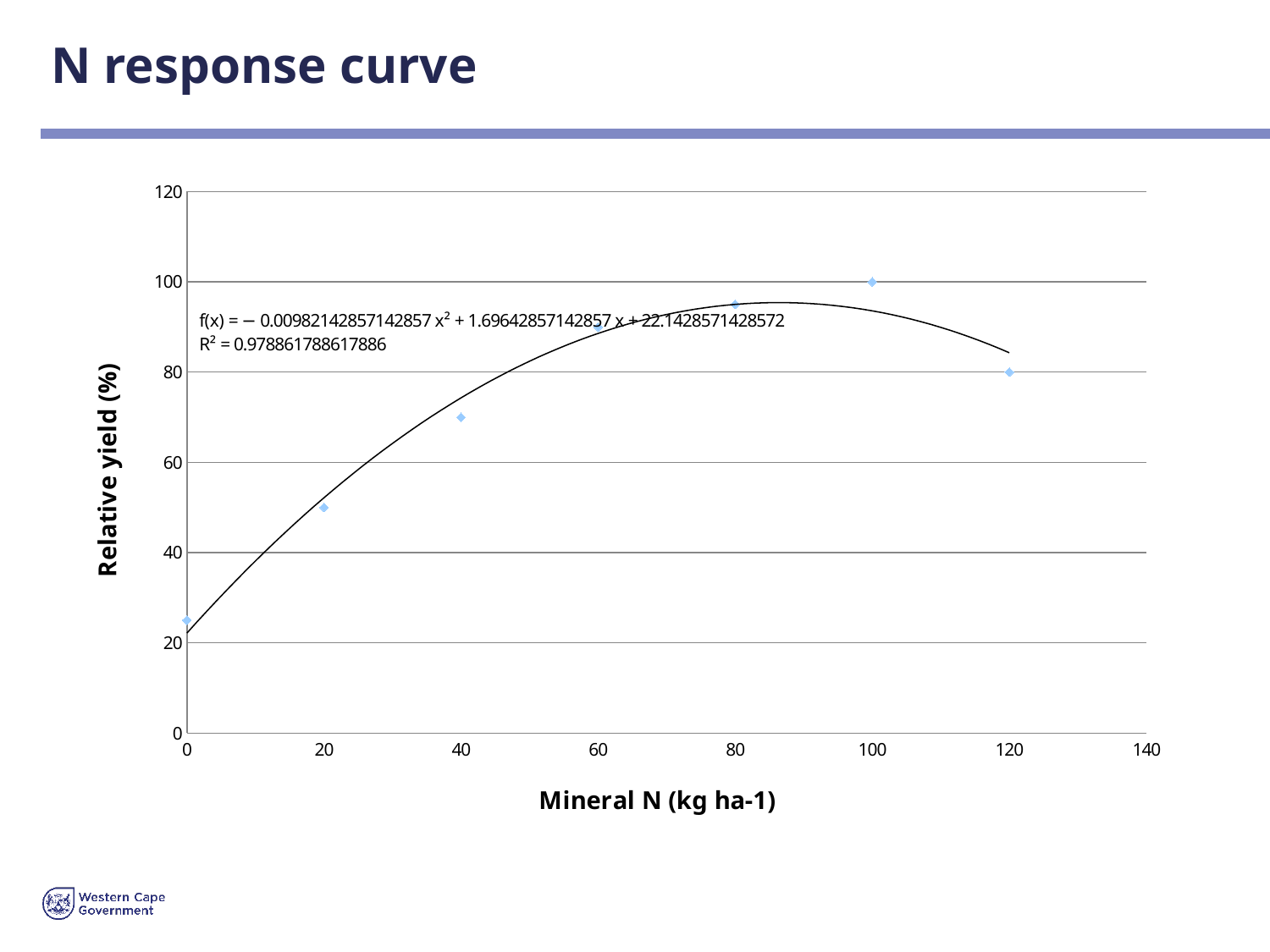
How many data points are plotted on the chart? 7 At which mineral N level is the relative yield lowest? 0 What R² value is shown for the fitted curve? 0.978861788617886 Which has the higher relative yield: mineral N of 80 kg ha-1 or 120 kg ha-1? 80 kg ha-1 Is the relative yield at a mineral N of 40 kg ha-1 greater or less than 80? less What is the relative yield (%) at a mineral N of 120 kg ha-1? 80 What is the title of the x axis? Mineral N (kg ha-1) What is the relative yield (%) at a mineral N of 100 kg ha-1? 100 Is the relative yield at a mineral N of 0 kg ha-1 greater or less than 40? less Is the relative yield at a mineral N of 20 kg ha-1 greater or less than 40? greater What kind of chart is shown on the slide? Scatter plot At which mineral N level is the relative yield highest? 100